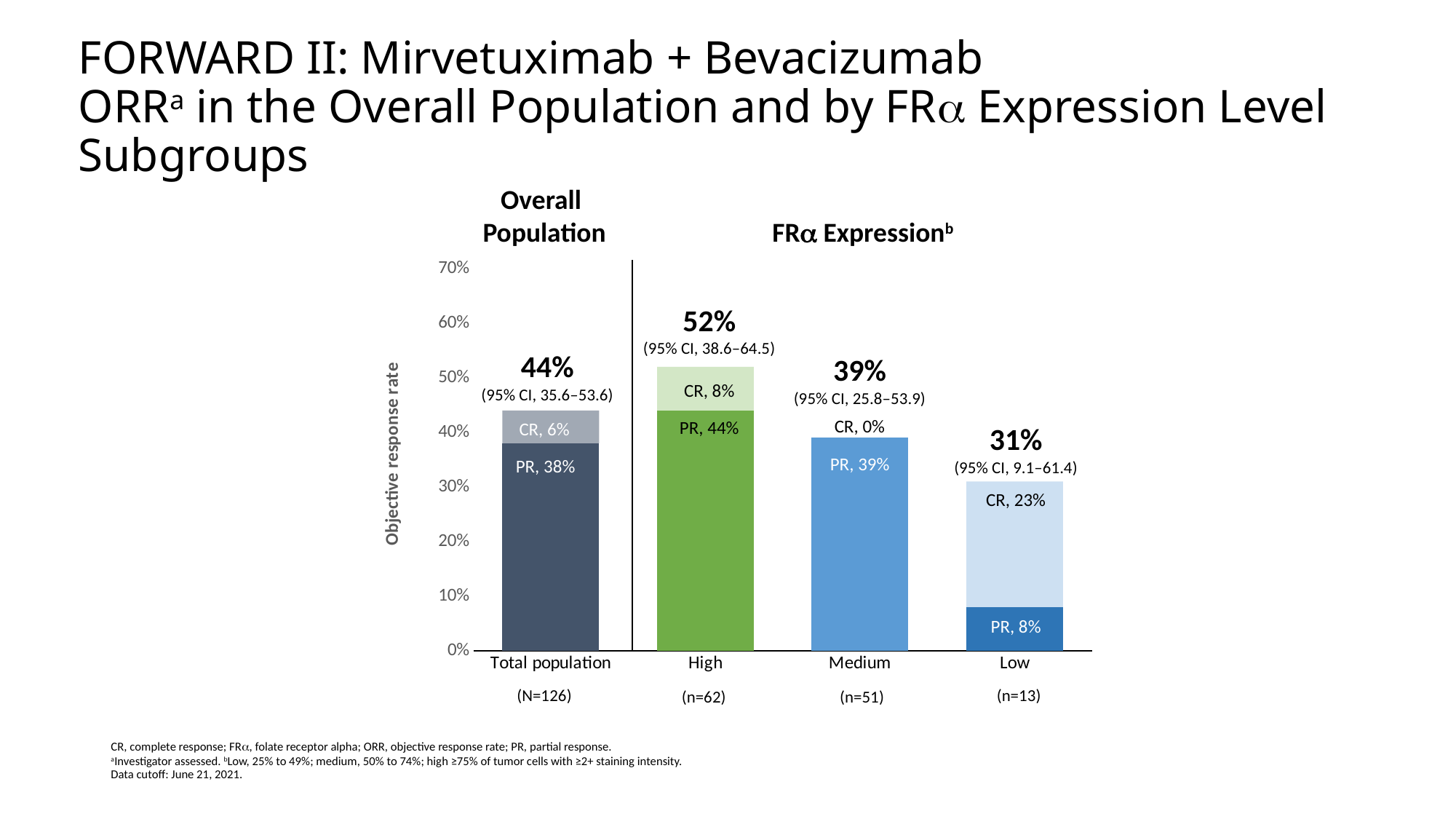
What is the PR value for the High FRα expression subgroup? 44% Which category has the lowest objective response rate? Low What is the 95% CI shown for the Total population? 35.6–53.6 What kind of chart is shown? Stacked bar chart What is the CR value for the Low FRα expression subgroup? 23% Which category has the highest objective response rate? High What is the objective response rate for the Total population? 44% What is the difference in objective response rate between the High and Low subgroups? 21% Which has a larger objective response rate, Medium or Low? Medium How many categories are shown on the x axis? 4 What is the label of the y axis? Objective response rate What is the total objective response rate for the Medium subgroup bar? 39%